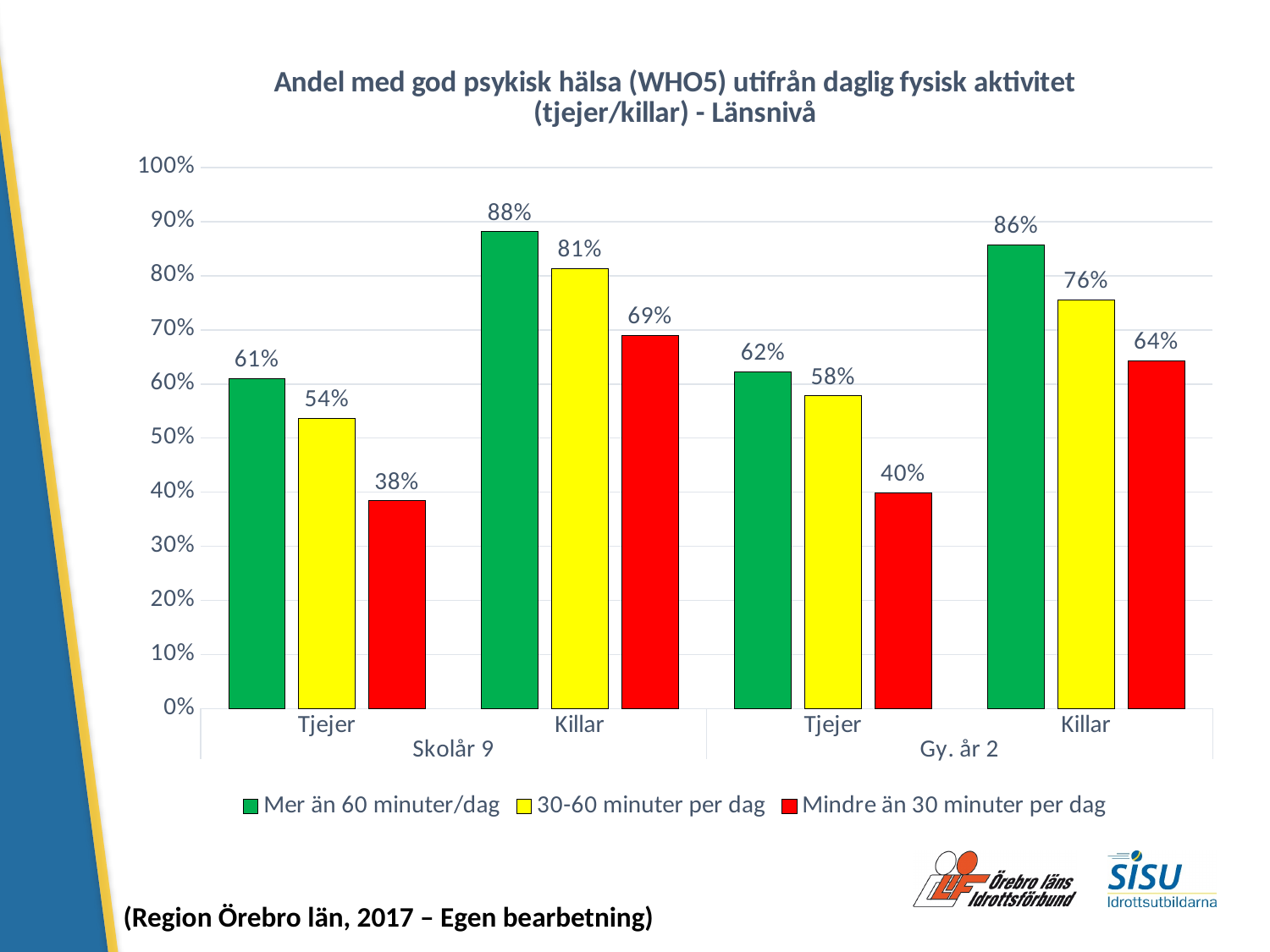
Which group and activity level has the lowest value in the chart? Tjejer, Skolår 9, Mindre än 30 minuter per dag (38%) What kind of chart is shown on the slide? Bar chart What is the value for 'Mer än 60 minuter/dag' among Tjejer in Skolår 9? 61% How many bars are plotted in the chart? 12 What is the difference between 'Mer än 60 minuter/dag' and 'Mindre än 30 minuter per dag' for Tjejer in Skolår 9? 23 percentage points Which group and activity level has the highest value in the chart? Killar, Skolår 9, Mer än 60 minuter/dag (88%) Which is larger: '30-60 minuter per dag' for Killar in Skolår 9 or for Killar in Gy. år 2? Killar in Skolår 9 (81%) What is the value for '30-60 minuter per dag' among Tjejer in Gy. år 2? 58% Is the value for 'Mindre än 30 minuter per dag' among Tjejer in Gy. år 2 greater or less than 50%? less What is the value for 'Mindre än 30 minuter per dag' among Killar in Gy. år 2? 64% How many series does the legend list? 3 Which colour represents 'Mindre än 30 minuter per dag' in the chart? Red